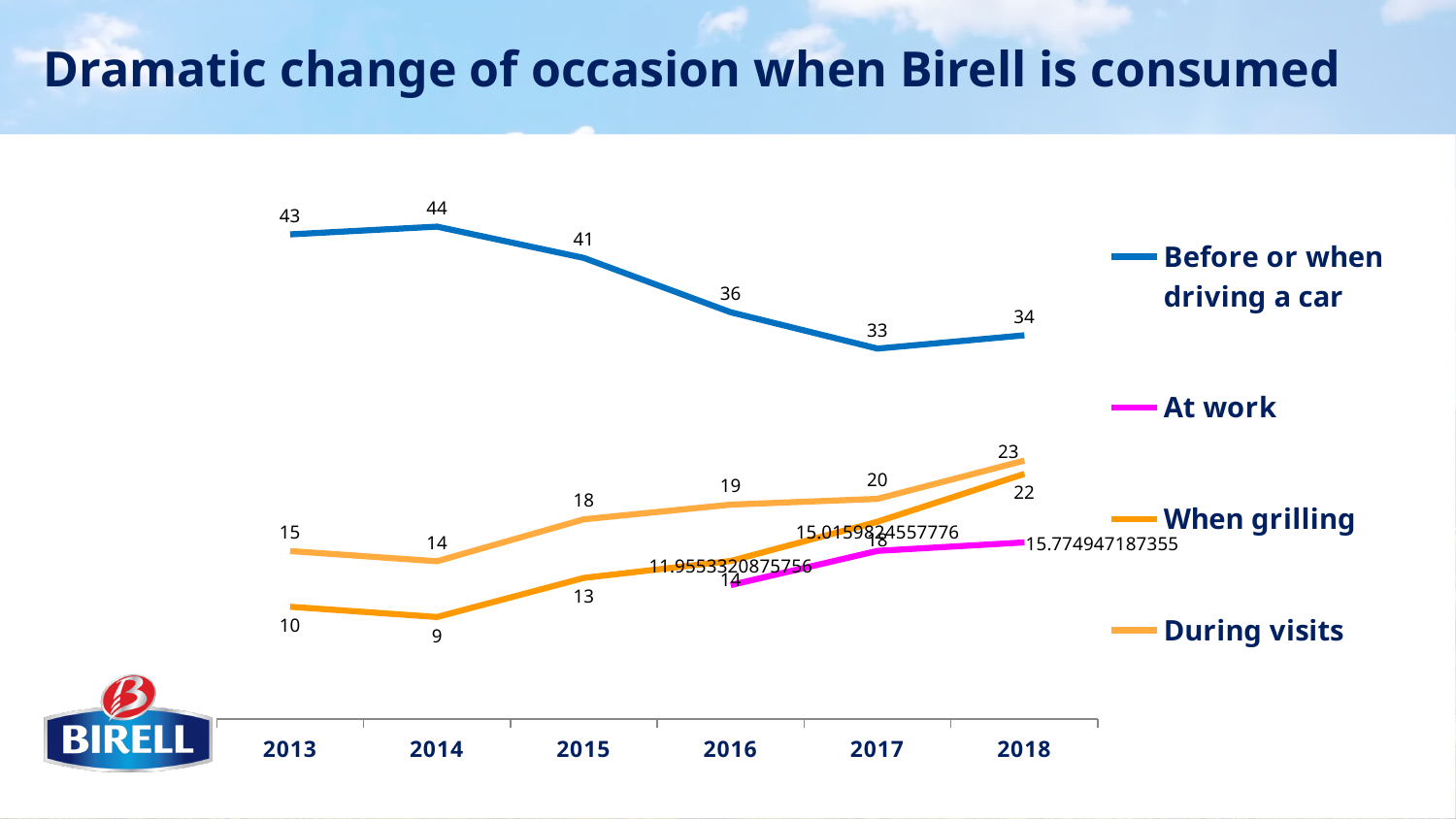
How many years are shown on the x axis? 6 What is the value for 'When grilling' in 2014? 9 Does the 'Before or when driving a car' series generally rise or fall from 2013 to 2018? fall What is the value for 'During visits' in 2018? 23 What is the value for 'Before or when driving a car' in 2014? 44 In which year is the value for 'When grilling' the highest? 2018 What type of chart is shown on the slide? line chart In which year is the value for 'Before or when driving a car' the lowest? 2017 What is the difference between the 'Before or when driving a car' values in 2013 and 2018? 9 Which is larger in 2018: the value for 'During visits' or the value for 'When grilling'? During visits How many series does the legend list? 4 Which series is drawn in magenta? At work